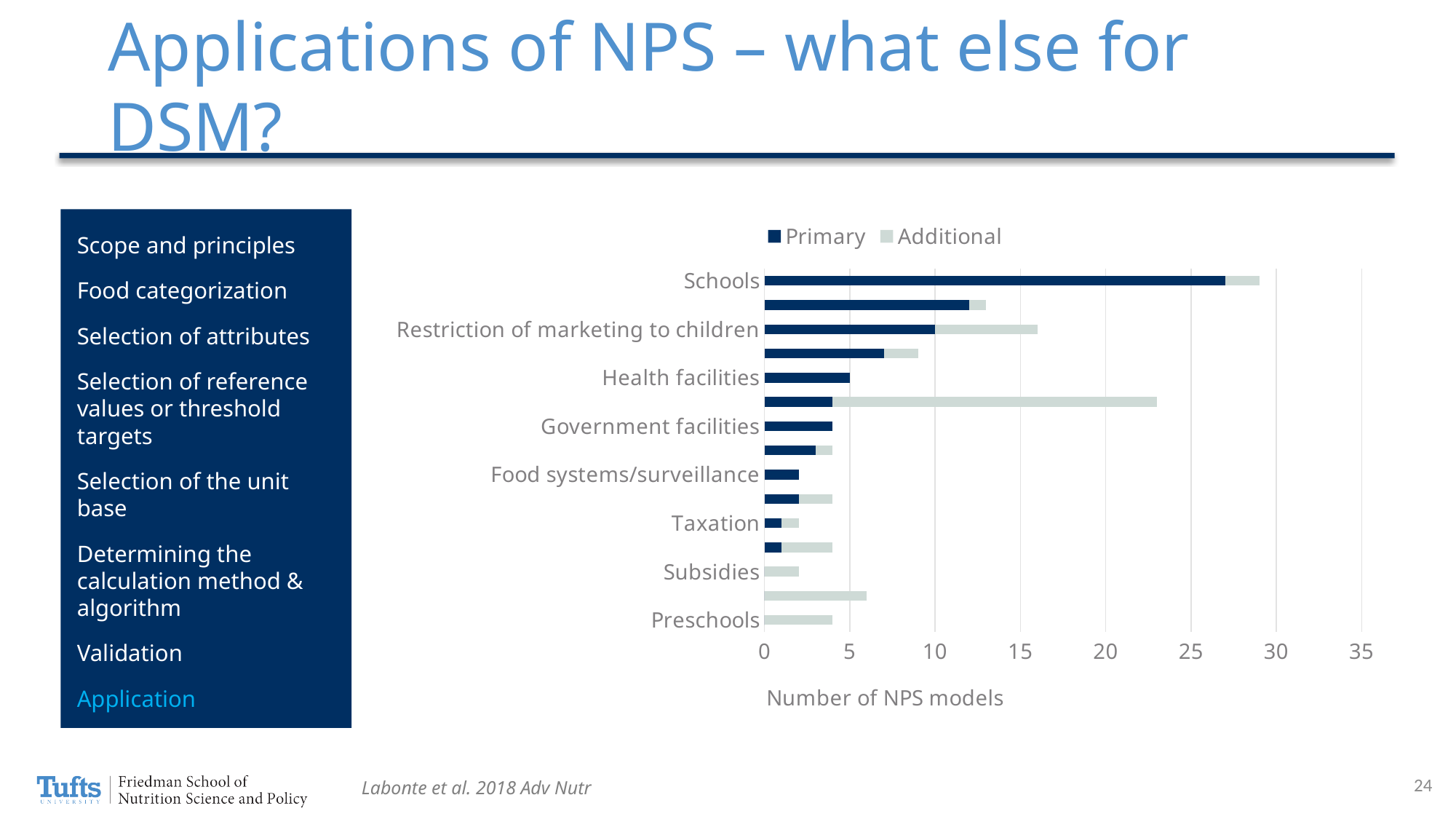
How many series does the chart's legend list? 2 Which has a longer total bar, Schools or Health facilities? Schools What kind of chart is shown on the slide? bar chart Is the total bar length for Schools greater or less than 25? greater Is the total bar length for Health facilities greater or less than 10? less What is the title of the horizontal axis of the chart? Number of NPS models Is the total bar length for Restriction of marketing to children greater or less than 10? greater Which labeled category has the longest bar in the chart? Schools Which has a longer total bar, Restriction of marketing to children or Government facilities? Restriction of marketing to children What are the two series named in the chart's legend? Primary and Additional